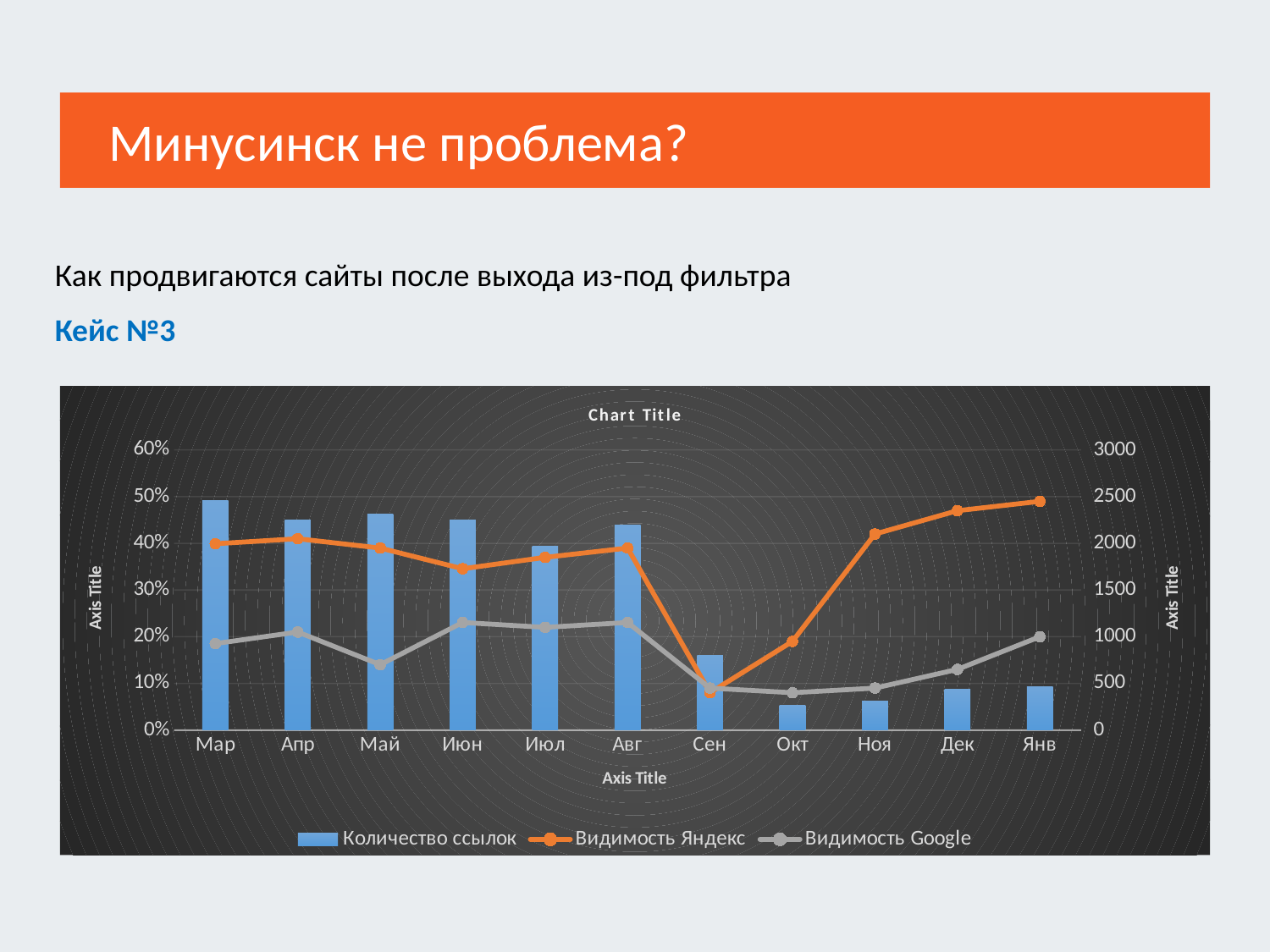
Which is larger in Ноя: Видимость Яндекс or Видимость Google? Видимость Яндекс How many series does the legend list? 3 What is the title shown at the top of the chart? Chart Title How many months are shown on the x axis? 11 Does Видимость Яндекс rise or fall from Сен to Янв? rise Is the Видимость Яндекс value for Сен greater or less than 20%? less In which month is Видимость Яндекс highest? Янв Is the Количество ссылок value for Мар greater or less than 2000? greater Which month has the highest bar for Количество ссылок? Мар In which month is Видимость Яндекс lowest? Сен Is the Количество ссылок value for Окт greater or less than 500? less What kind of chart is this? Combined bar and line chart